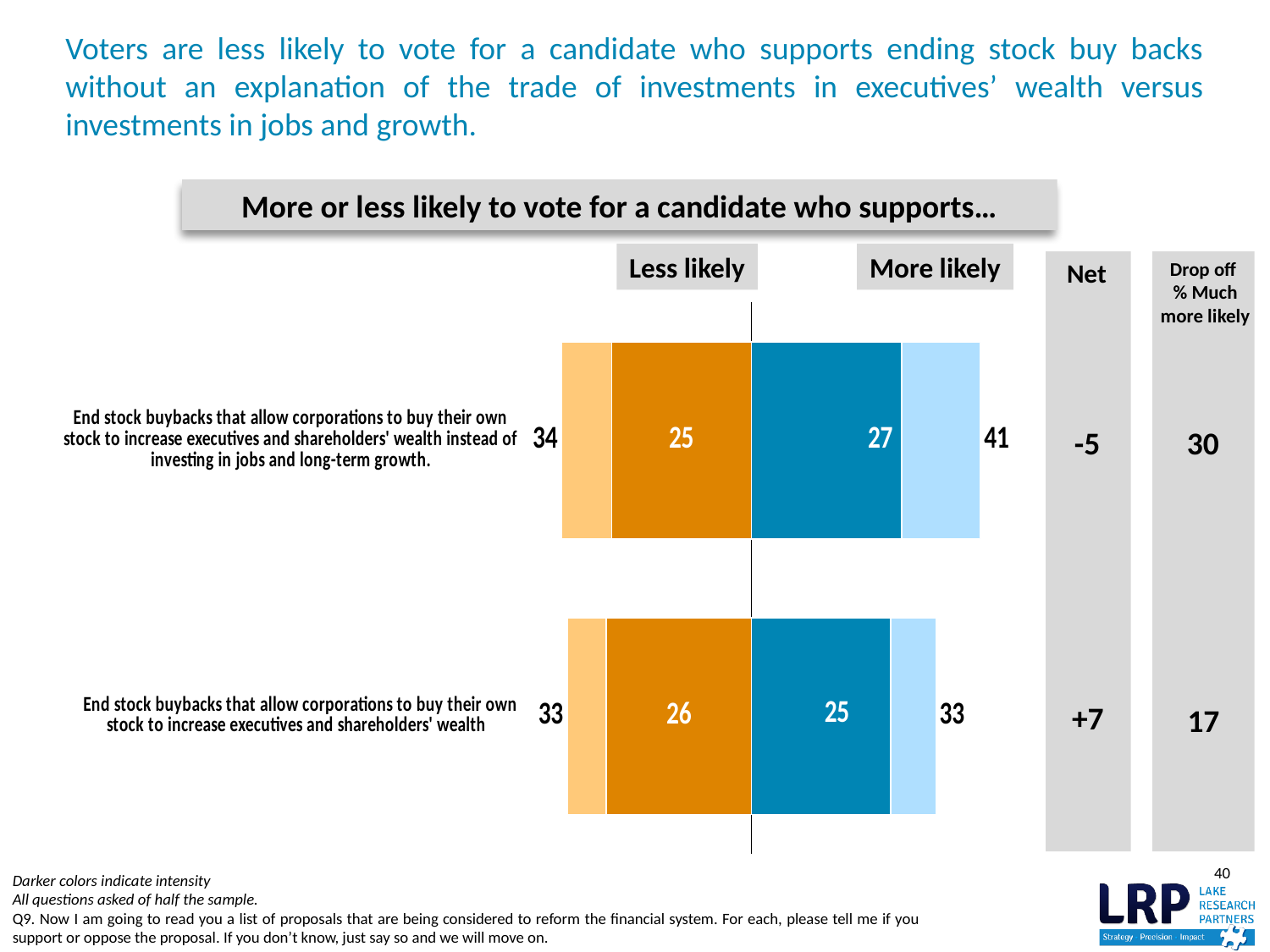
What is the title shown above the chart? More or less likely to vote for a candidate who supports… How many proposals are shown in the chart? 2 What is the dark orange (much less likely) value for the proposal that mentions investing in jobs and long-term growth? 25 What is the total 'More likely' value for the proposal to end stock buybacks that mentions investing in jobs and long-term growth? 41 What is the total 'Less likely' value for the proposal to end stock buybacks that mentions investing in jobs and long-term growth? 34 Is the 'Net' value larger for the proposal that mentions jobs and long-term growth or for the proposal that only mentions executives and shareholders' wealth? The proposal that only mentions executives and shareholders' wealth What is the 'Drop off % Much more likely' value for the proposal that mentions investing in jobs and long-term growth? 30 What is the dark blue (much more likely) value for the proposal that only mentions increasing executives and shareholders' wealth? 25 What type of chart is shown on the slide? Bar chart What is the 'Net' value for the proposal to end stock buybacks that only mentions increasing executives and shareholders' wealth? +7 What is the difference between the 'More likely' totals of the two proposals (41 and 33)? 8 Which proposal has the higher total 'More likely' value? End stock buybacks that allow corporations to buy their own stock to increase executives and shareholders' wealth instead of investing in jobs and long-term growth.